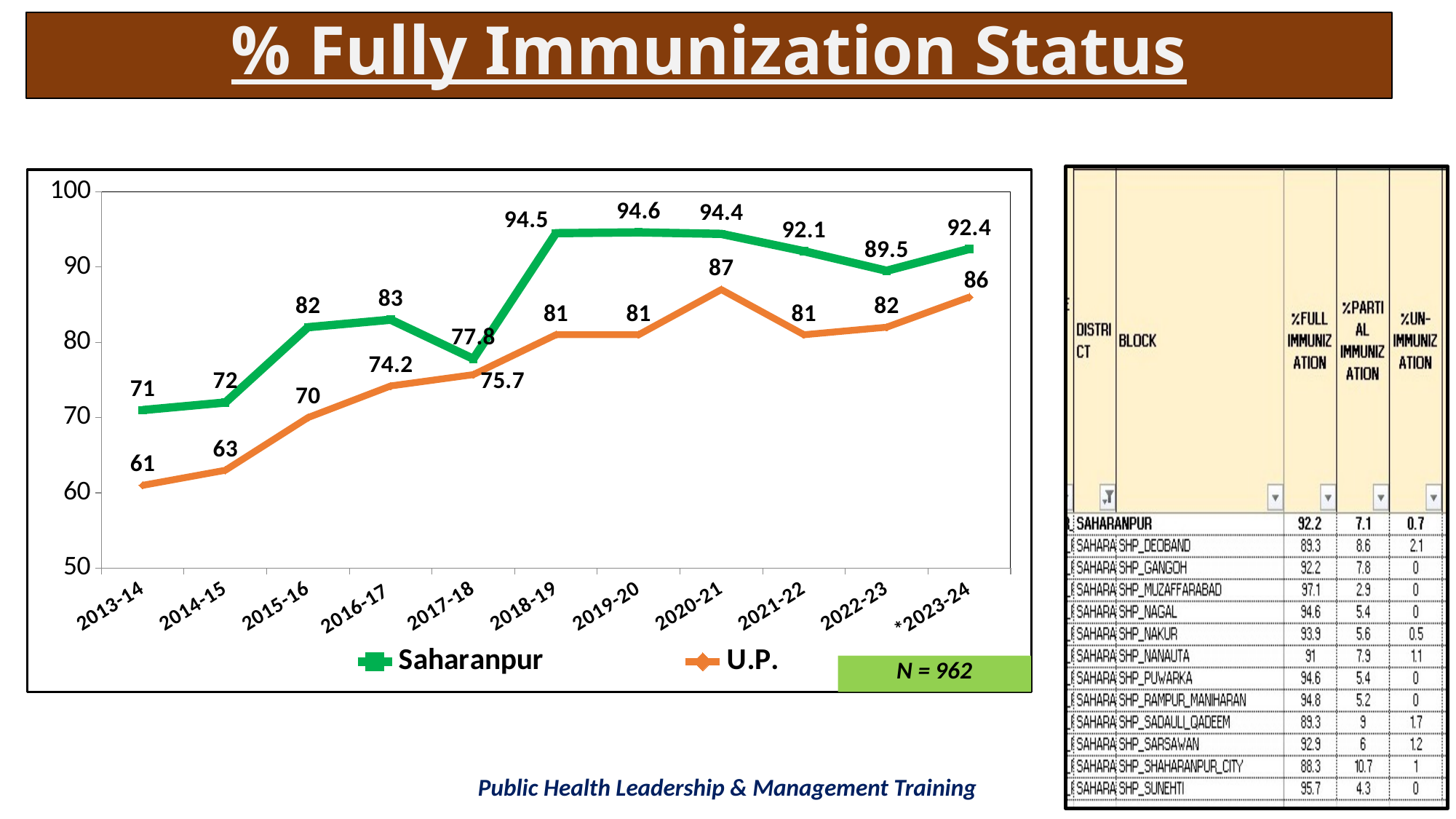
Which series has the larger value in 2017-18, Saharanpur or U.P.? Saharanpur In which year is the U.P. value highest? 2020-21 How many years are plotted on the x axis of the chart? 11 What is the value for Saharanpur in 2013-14? 71 What kind of chart is shown on the slide? Line chart How many series does the chart legend list? 2 In which year is the Saharanpur value lowest? 2013-14 What is the value for U.P. in 2020-21? 87 What is the difference between the Saharanpur and U.P. values in 2013-14? 10 What is the difference between the Saharanpur and U.P. values in *2023-24? 6.4 What is the value for U.P. in *2023-24? 86 What is the value for Saharanpur in 2017-18? 77.8